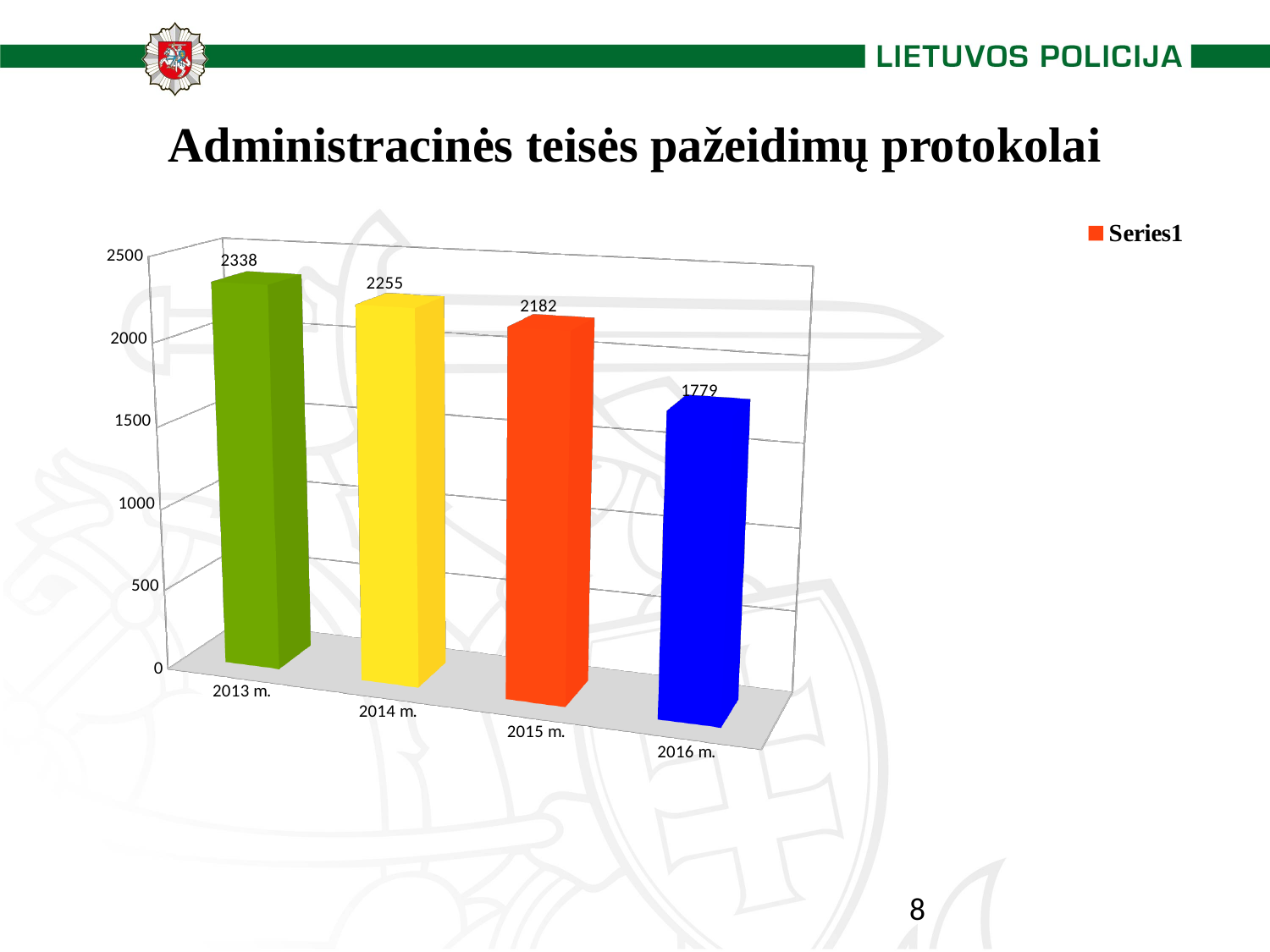
What is the value for 2014 m.? 2255 Which year has the lowest value? 2016 m. How many series does the legend list? 1 Which is larger, the value for 2015 m. or the value for 2016 m.? 2015 m. What kind of chart is shown? bar chart What is the value for 2016 m.? 1779 How many years are shown on the x axis? 4 What is the difference between the values for 2013 m. and 2016 m.? 559 What is the difference between the values for 2014 m. and 2015 m.? 73 What is the value for 2013 m.? 2338 Which year has the highest value? 2013 m. Do the values rise or fall from 2013 m. to 2016 m.? fall